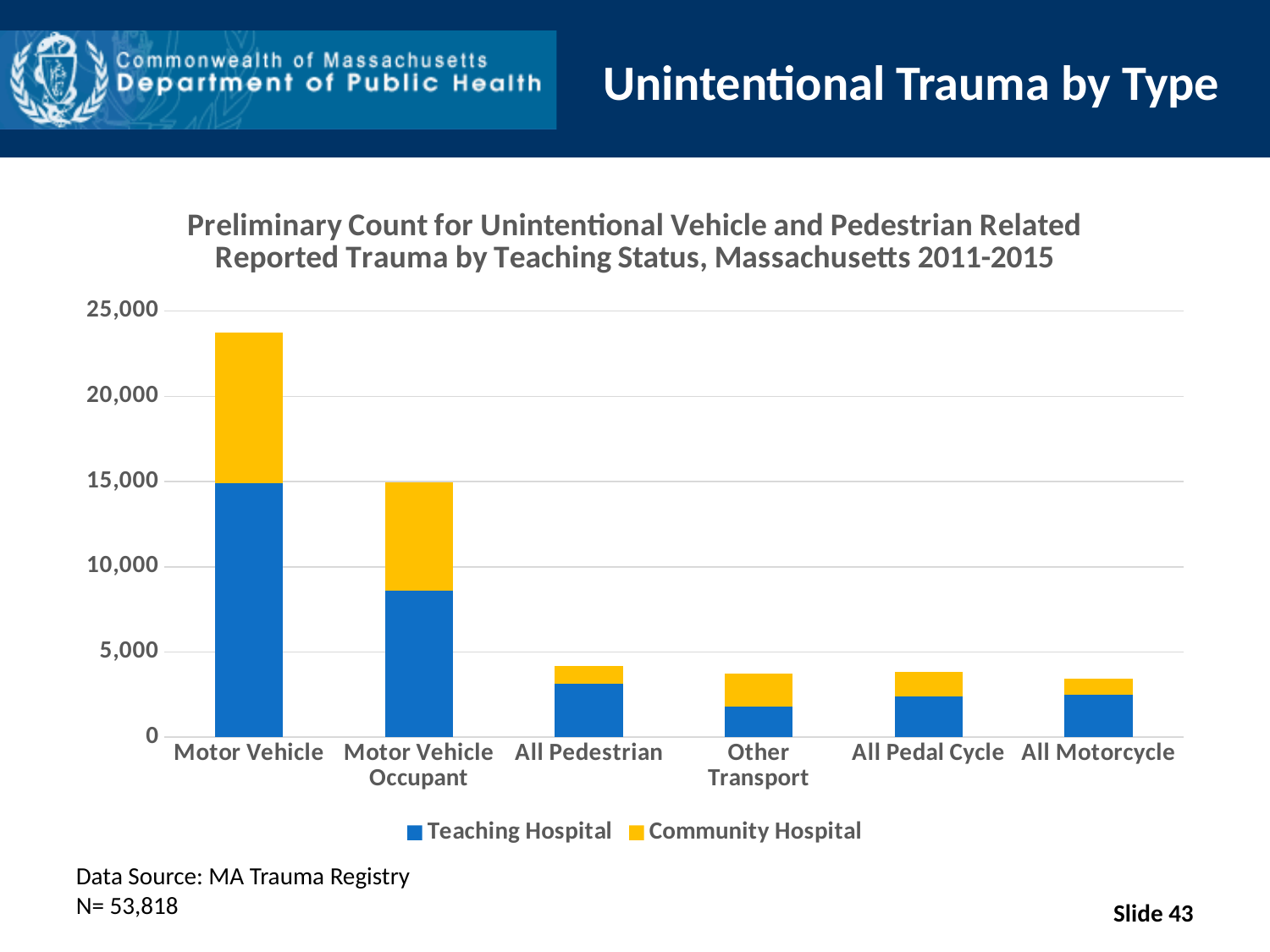
Which series is shown in yellow in the legend? Community Hospital How many trauma type categories are shown on the x axis? 6 Which has a larger total count, Motor Vehicle or Motor Vehicle Occupant? Motor Vehicle How many series does the legend list? 2 What years does the chart title say the data covers? 2011-2015 Is the total count for Motor Vehicle greater or less than 20,000? greater Is the total count for Motor Vehicle Occupant greater or less than 10,000? greater Which category has the highest total count? Motor Vehicle Is the total count for All Pedestrian greater or less than 5,000? less What kind of chart is shown on the slide? bar chart Which category has the lowest Teaching Hospital count? Other Transport